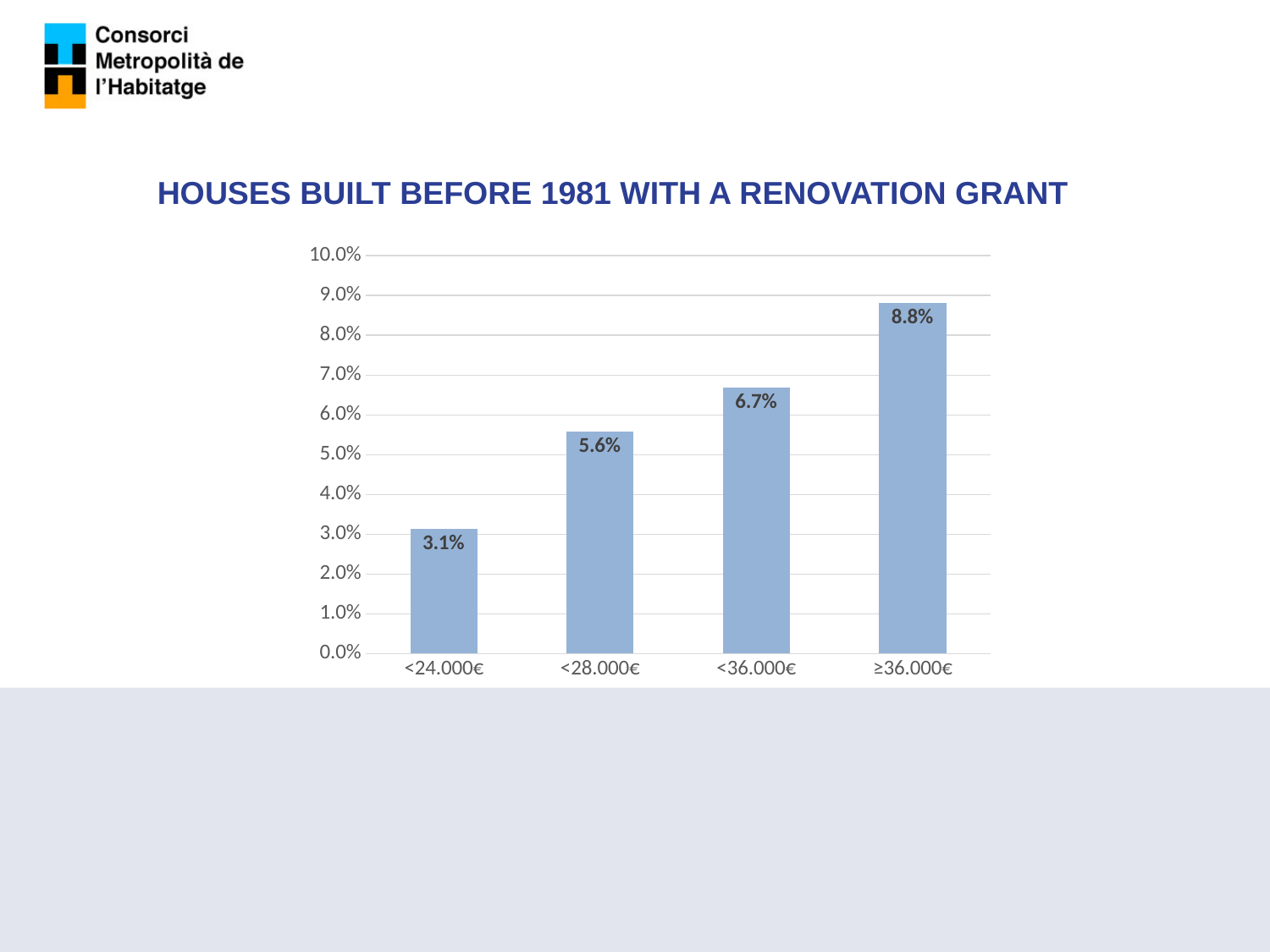
What kind of chart is shown on the slide? Bar chart Which category has the highest value? ≥36.000€ What is the value for the ≥36.000€ category? 8.8% What is the difference between the values for <36.000€ and <28.000€? 1.1% Do the values rise or fall from left to right along the x axis? Rise Which is larger, the value for <28.000€ or the value for <36.000€? <36.000€ What is the value for the <28.000€ category? 5.6% What is the value for the <24.000€ category? 3.1% How many categories are shown on the x axis? 4 Which category has the lowest value? <24.000€ What is the difference between the values for ≥36.000€ and <24.000€? 5.7% What is the value for the <36.000€ category? 6.7%